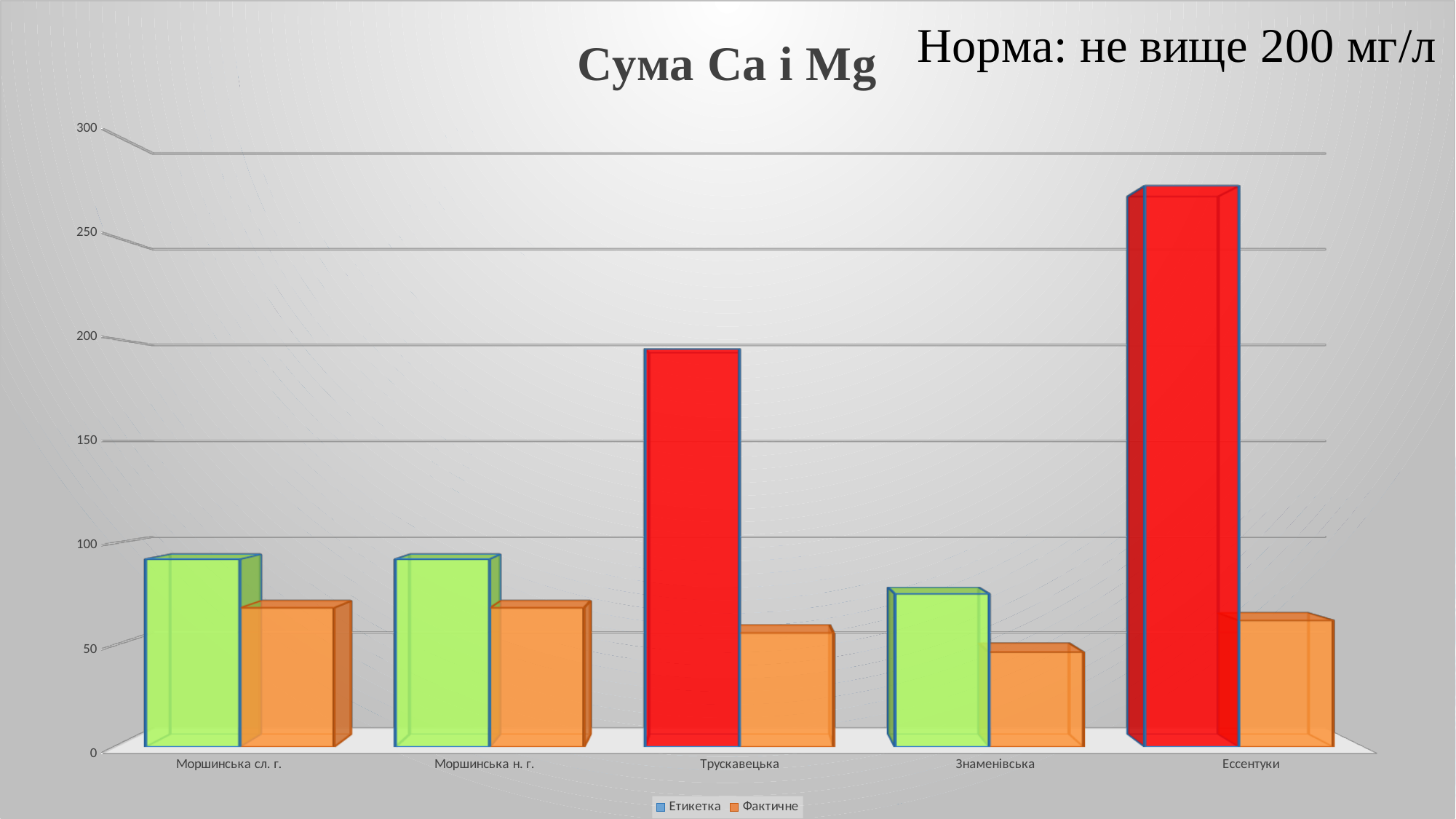
Which is larger for Трускавецька, the Етикетка value or the Фактичне value? Етикетка Is the Етикетка value for Знаменівська greater or less than 100? less How many series does the legend list? 2 Is the Етикетка value for Трускавецька greater or less than 150? greater How many categories are shown on the x axis? 5 Which has the larger Етикетка value, Ессентуки or Трускавецька? Ессентуки What is the title of the chart? Сума Ca і Mg Which category has the lowest Етикетка value? Знаменівська What kind of chart is shown on the slide? bar chart What are the two series named in the legend? Етикетка and Фактичне Which category has the highest Етикетка value? Ессентуки Is the Етикетка value for Ессентуки greater or less than 200? greater